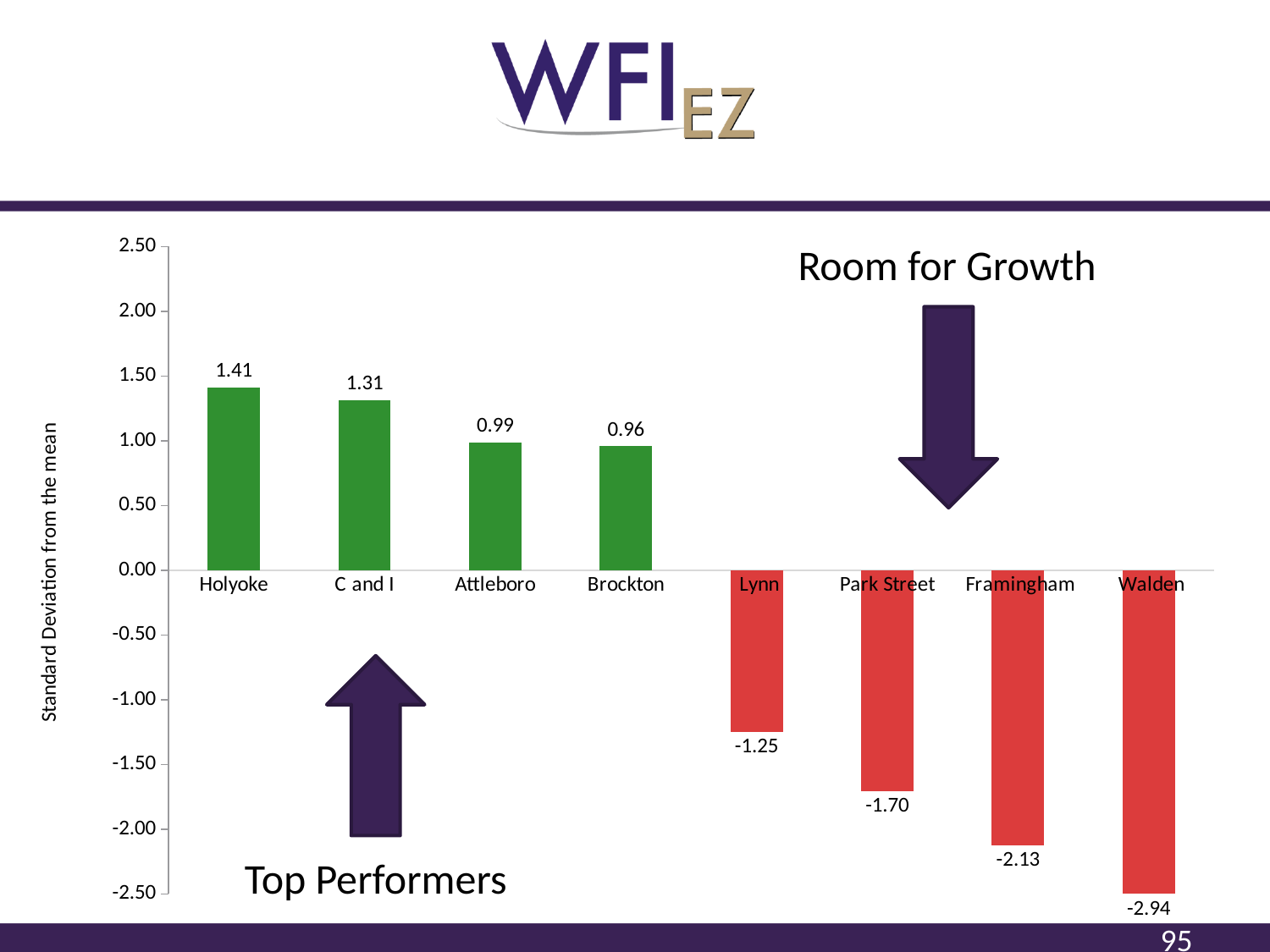
What is the label of the vertical axis? Standard Deviation from the mean What is the value for Holyoke? 1.41 Which category has the lowest value? Walden What kind of chart is shown on the slide? bar chart What is the difference between the values for Holyoke and C and I? 0.10 Is the value for Framingham greater or less than -2.00? less What is the value for Walden? -2.94 How many categories are shown on the x axis? 8 Which is larger, the value for Attleboro or the value for Brockton? Attleboro What is the difference between the values for Lynn and Framingham? 0.88 What is the value for Park Street? -1.70 Which category has the highest value? Holyoke